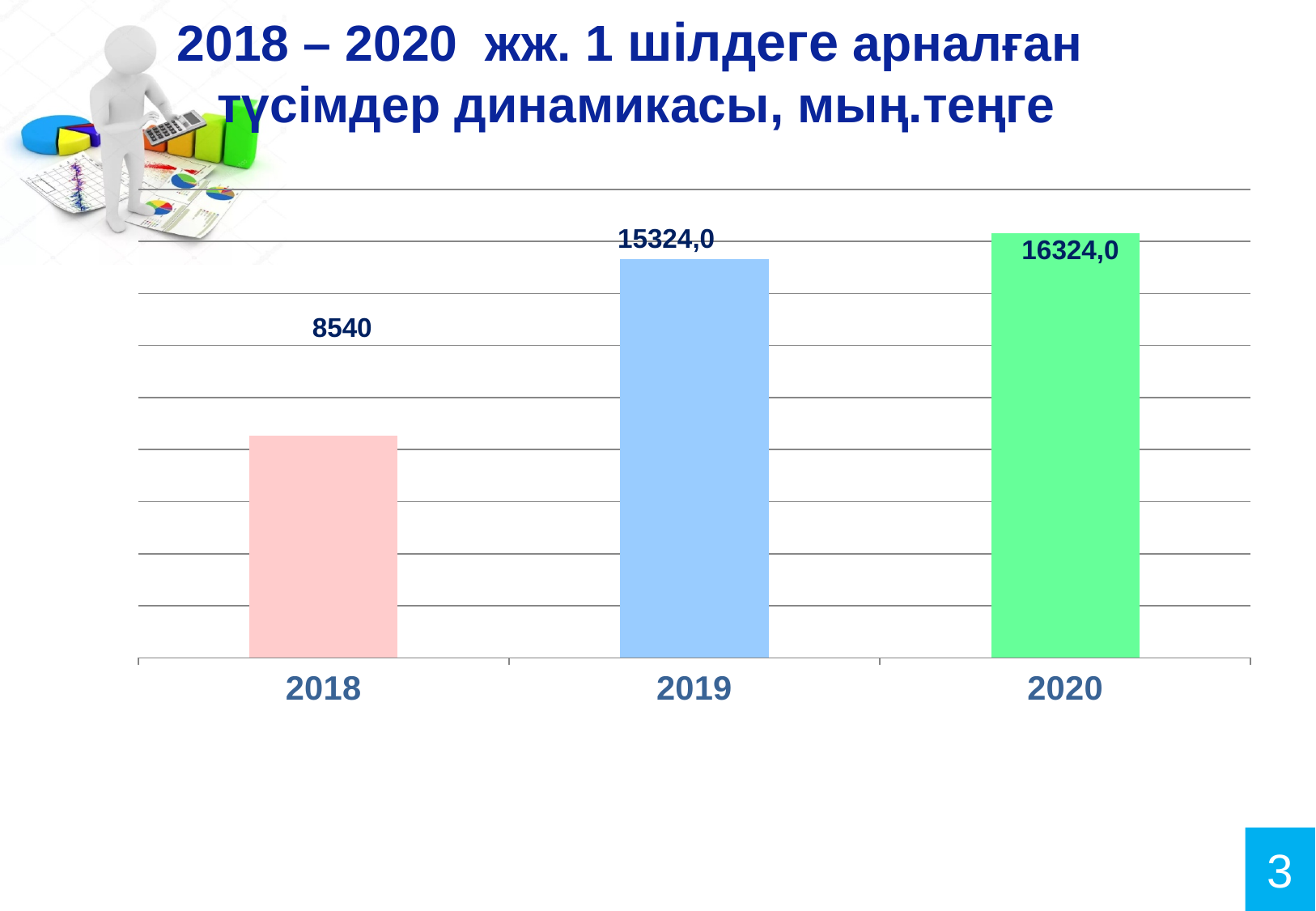
What kind of chart is shown on the slide? bar chart Do the values rise or fall from 2018 to 2020? rise Which year has the lowest value? 2018 What is the difference between the values for 2019 and 2018? 6784,0 What is the difference between the values for 2020 and 2019? 1000,0 Which is larger, the value for 2018 or the value for 2019? 2019 How many years are shown on the x axis? 3 What is the value for 2019? 15324,0 Which year has the highest value? 2020 What colour is the bar for 2020? green What is the value for 2020? 16324,0 What is the value for 2018? 8540